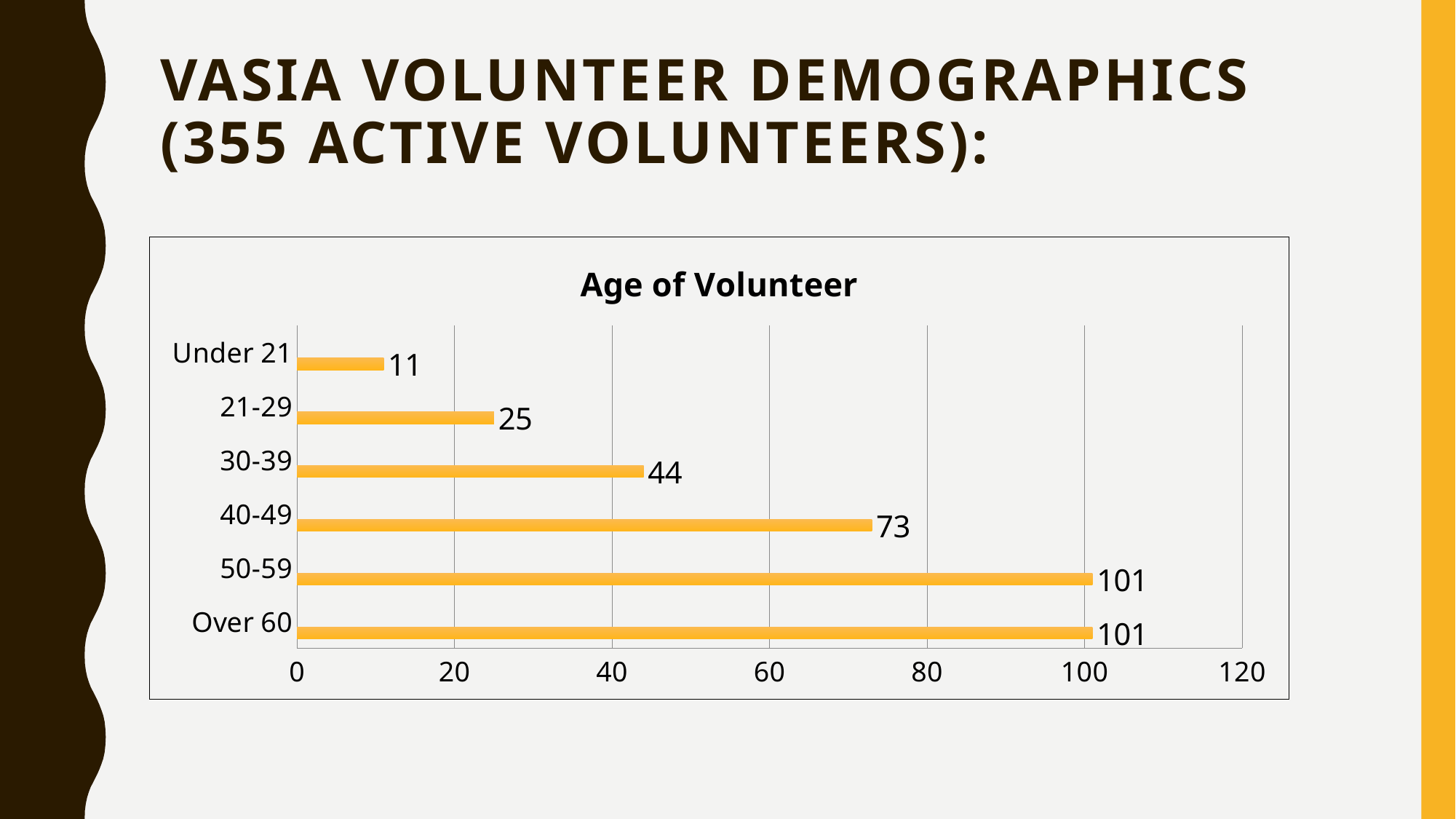
What is the difference between the values for 40-49 and 30-39? 29 What is the value for the 30-39 age group? 44 Which is larger, the value for 21-29 or the value for 30-39? 30-39 Is the value for 40-49 greater or less than 60? greater Which age group has the lowest value? Under 21 What is the title of the chart? Age of Volunteer What kind of chart is shown on the slide? bar chart How many age groups are shown in the chart? 6 What is the difference between the values for 50-59 and 21-29? 76 What is the value for the Over 60 age group? 101 What is the value for the Under 21 age group? 11 What is the value for the 40-49 age group? 73